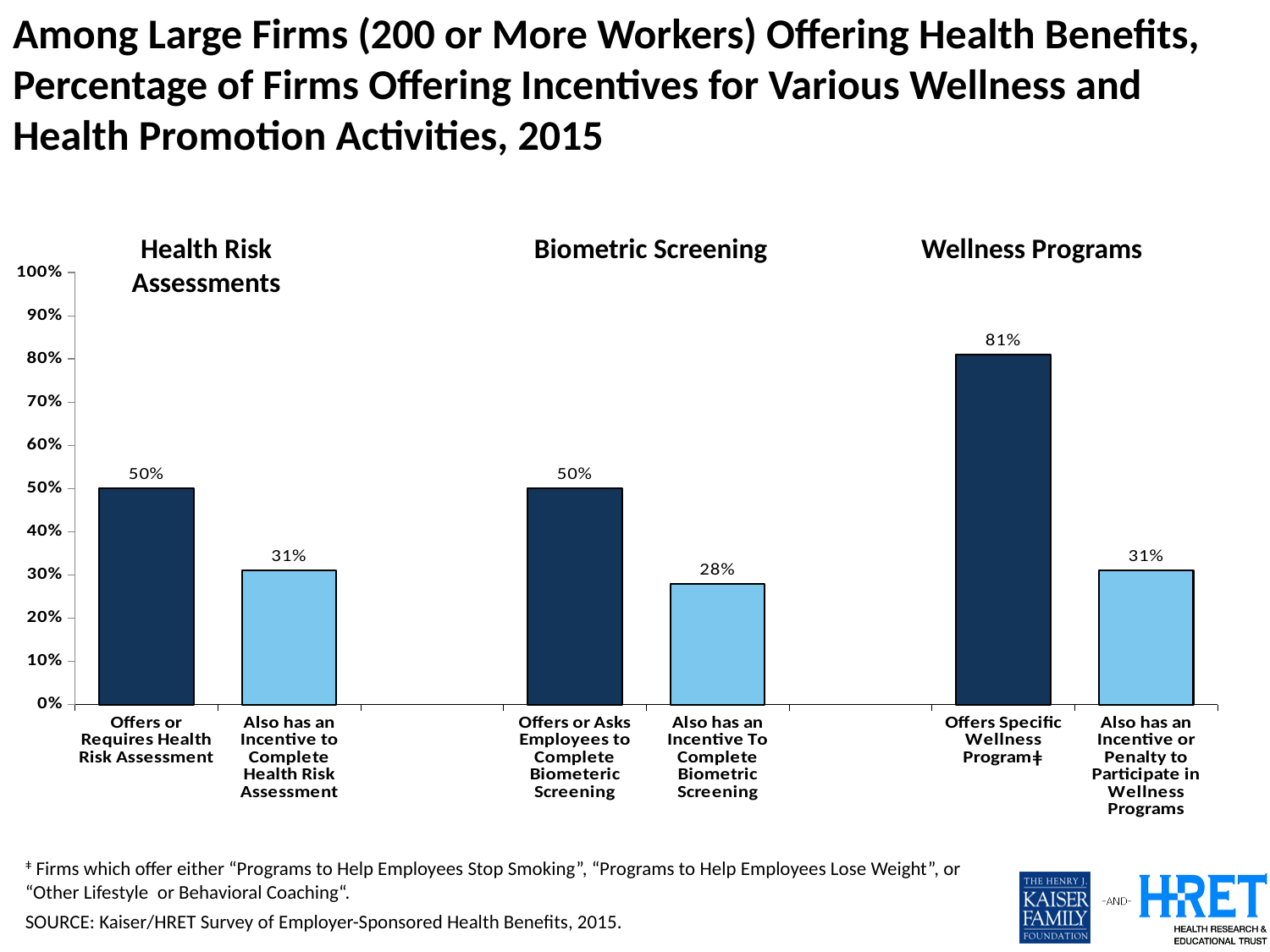
What percentage of large firms also have an incentive to complete biometric screening? 28% Which category has the highest value on the chart? Offers Specific Wellness Program What percentage of large firms offer or require a health risk assessment? 50% Which is larger: the percentage of firms with an incentive to complete a health risk assessment or the percentage with an incentive to complete biometric screening? Incentive to complete a health risk assessment What is the difference between the percentage of firms that offer or ask employees to complete biometric screening and the percentage that also have an incentive to complete it? 22 percentage points What are the three group headings shown above the bars? Health Risk Assessments, Biometric Screening, Wellness Programs What percentage of large firms also have an incentive to complete a health risk assessment? 31% How many bars are plotted on the chart? 6 What percentage of large firms offer a specific wellness program? 81% Which category has the lowest value on the chart? Also has an Incentive To Complete Biometric Screening What type of chart is shown on the slide? Bar chart What is the difference between the percentage of firms offering a specific wellness program and the percentage that also have an incentive or penalty to participate in wellness programs? 50 percentage points